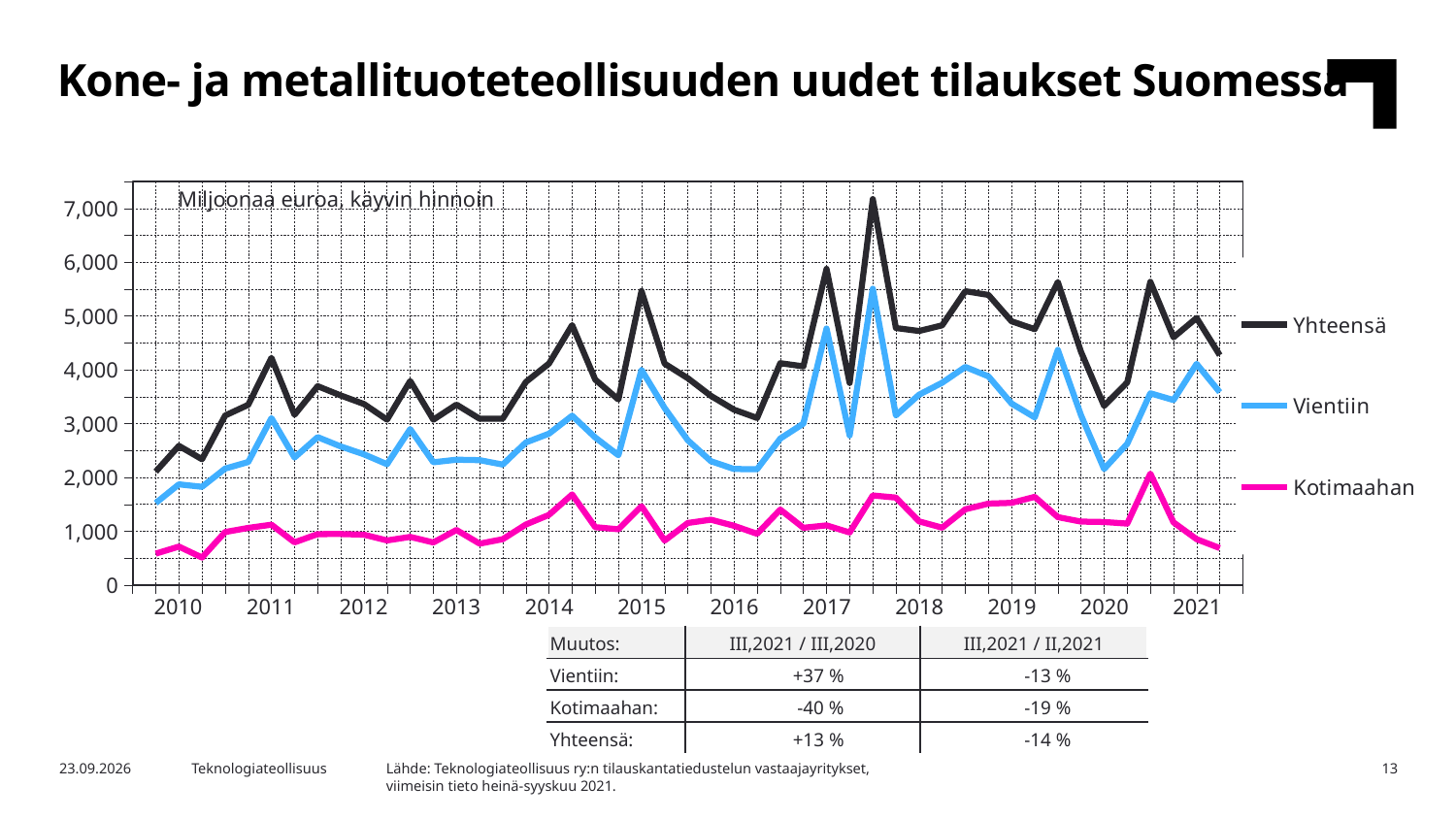
Is the highest value of the Yhteensä series (around 2017) greater or less than 6,000? greater In the table below the chart, what is the change for Vientiin for III,2021 / III,2020? +37 % What kind of chart is shown on the slide? line chart Is the first value of the Kotimaahan series in 2010 greater or less than 1,000? less In the table below the chart, what is the change for Yhteensä for III,2021 / II,2021? -14 % Which series are listed in the chart legend? Yhteensä, Vientiin, Kotimaahan Which series is higher throughout the chart, Vientiin or Kotimaahan? Vientiin How many series does the legend of the chart list? 3 What unit is stated inside the chart area? Miljoonaa euroa, käyvin hinnoin How many years are labelled on the x axis of the chart? 12 Is the highest value of the Kotimaahan series greater or less than 3,000? less Does the Yhteensä series rise or fall from the start of 2010 to the start of 2011? rise